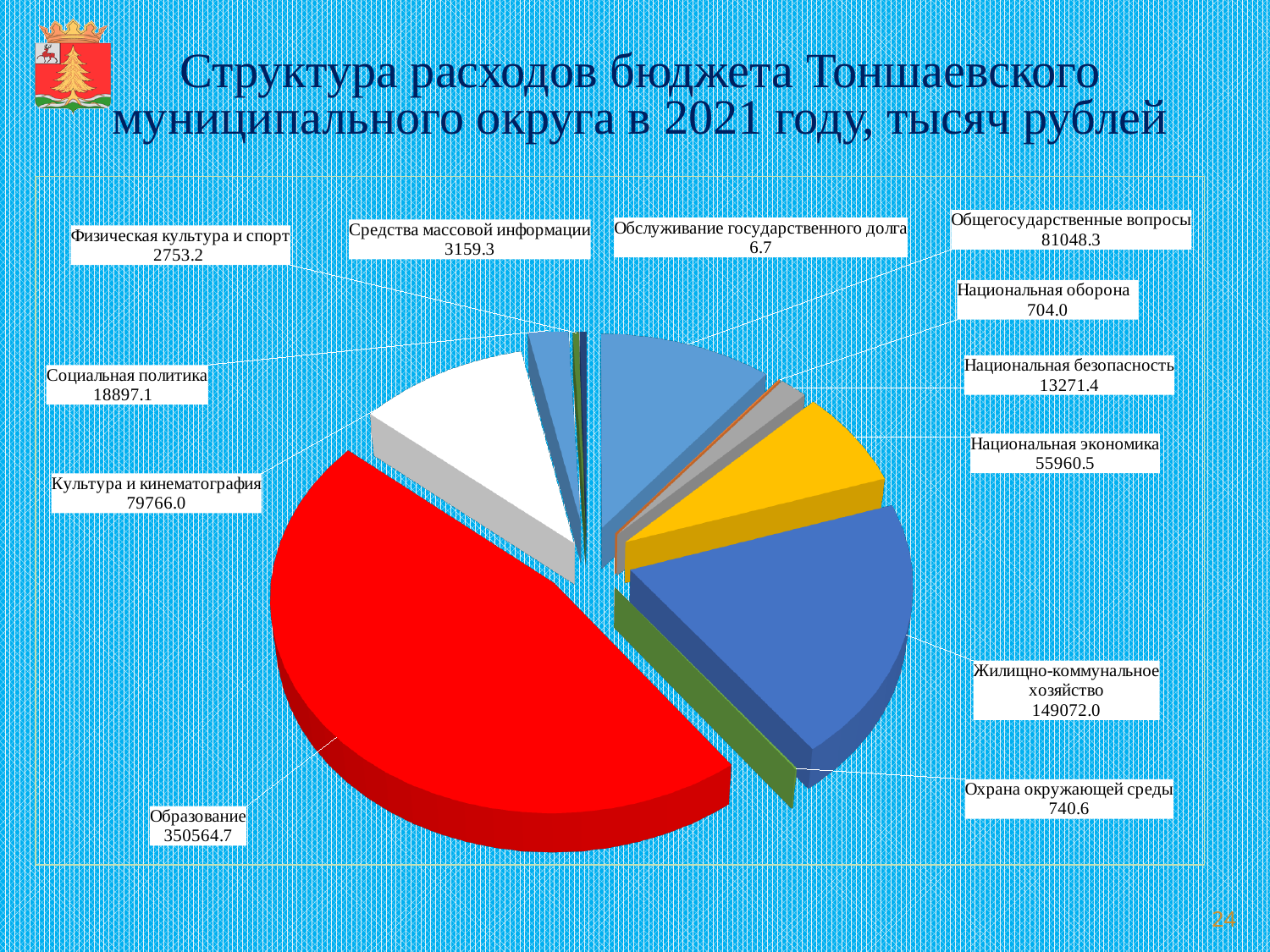
What is the value for Образование? 350564.7 What is the value for Социальная политика? 18897.1 In what units are the values in the chart expressed, according to the title? тысяч рублей Which is larger: Общегосударственные вопросы or Культура и кинематография? Общегосударственные вопросы How many categories (slices) does the pie chart show? 12 What is the difference between Жилищно-коммунальное хозяйство and Общегосударственные вопросы? 68023.7 Which category has the largest value in the pie chart? Образование What is the value for Национальная оборона? 704.0 What kind of chart is shown on the slide? Pie chart What is the difference between Национальная экономика and Социальная политика? 37063.4 Which category has the smallest value in the pie chart? Обслуживание государственного долга What is the value for Жилищно-коммунальное хозяйство? 149072.0